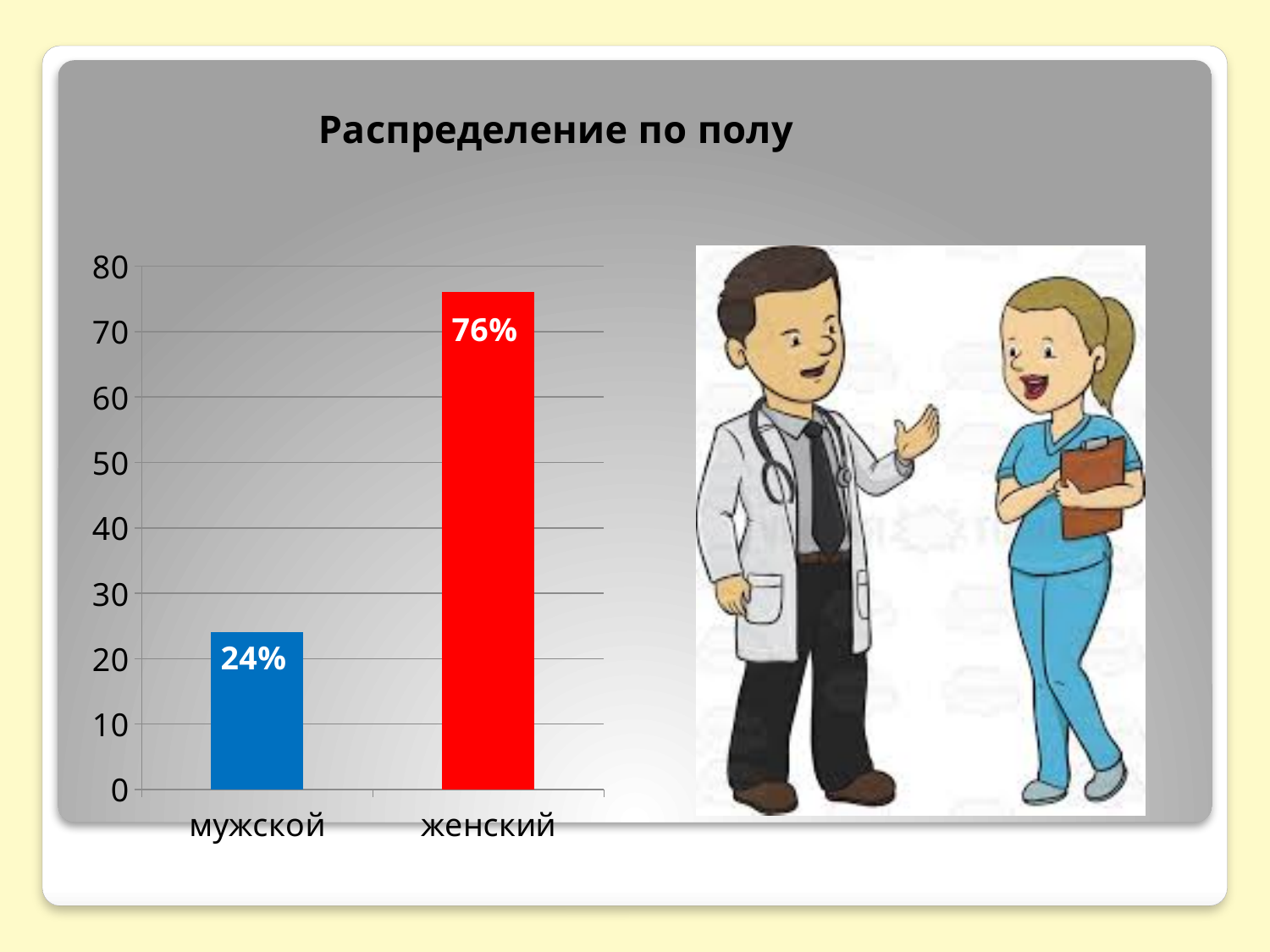
What is the title of the chart? Распределение по полу Which category has the highest value? женский Is the value for мужской greater or less than 30? less What colour is the bar for женский? red What is the value for мужской? 24% Is the value for женский greater or less than 70? greater What is the difference between the values for женский and мужской? 52% What kind of chart is shown on the slide? bar chart Which category has the lowest value? мужской Which is larger, the value for мужской or the value for женский? женский How many categories are shown on the chart? 2 What is the value for женский? 76%